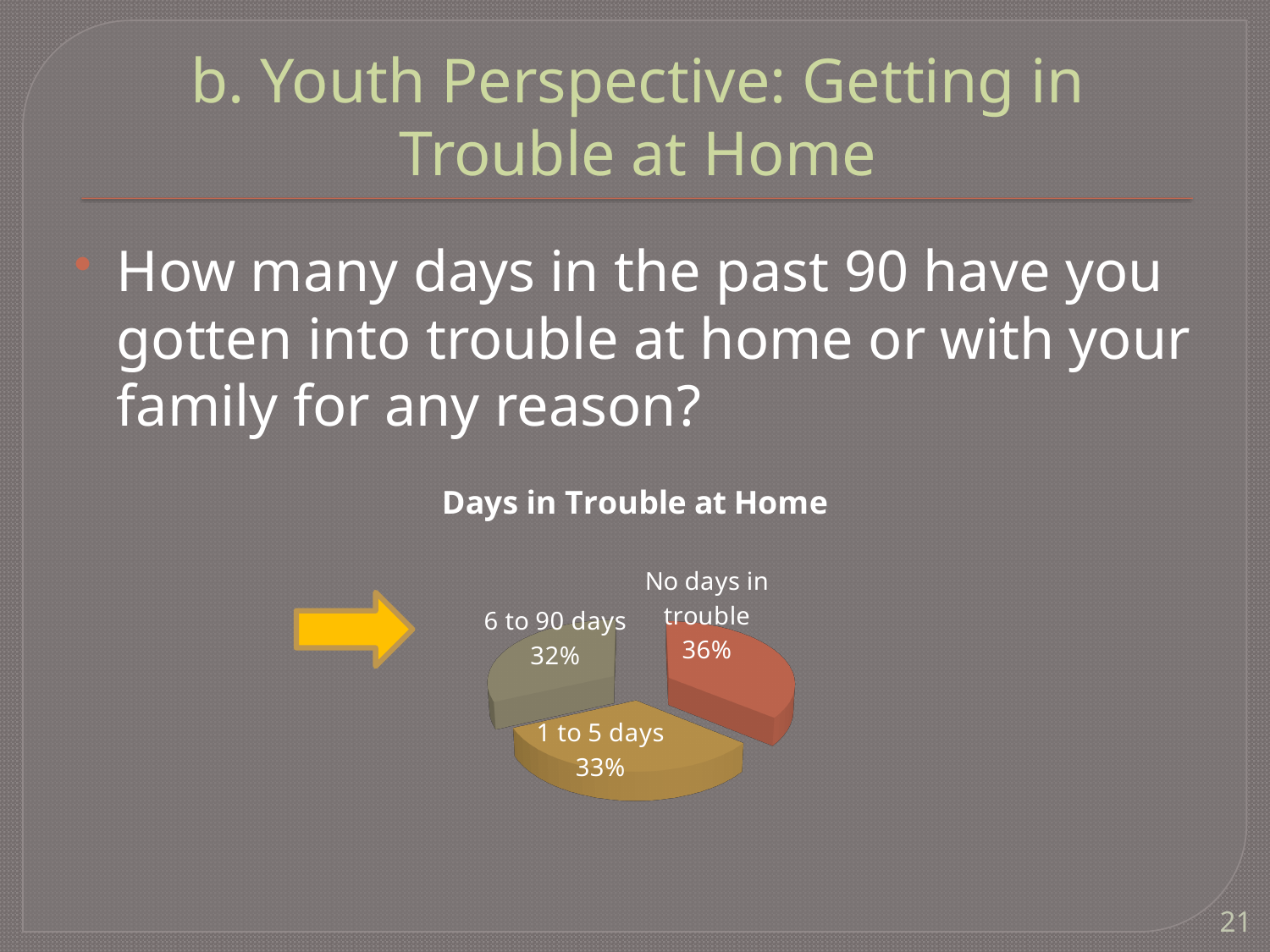
What share of the pie is labelled 'No days in trouble'? 36% What share of the pie is labelled '6 to 90 days'? 32% How many slices does the pie chart have? 3 Which slice of the pie chart is the smallest? 6 to 90 days What share of the pie is labelled '1 to 5 days'? 33% What is the difference in percentage points between the 'No days in trouble' slice and the '6 to 90 days' slice? 4 What is the title of the chart? Days in Trouble at Home What kind of chart is shown on the slide? pie chart Which slice of the pie chart is the largest? No days in trouble Which is larger, the 'No days in trouble' slice or the '1 to 5 days' slice? No days in trouble What colour is the 'No days in trouble' slice? red What is the difference in percentage points between the '1 to 5 days' slice and the '6 to 90 days' slice? 1